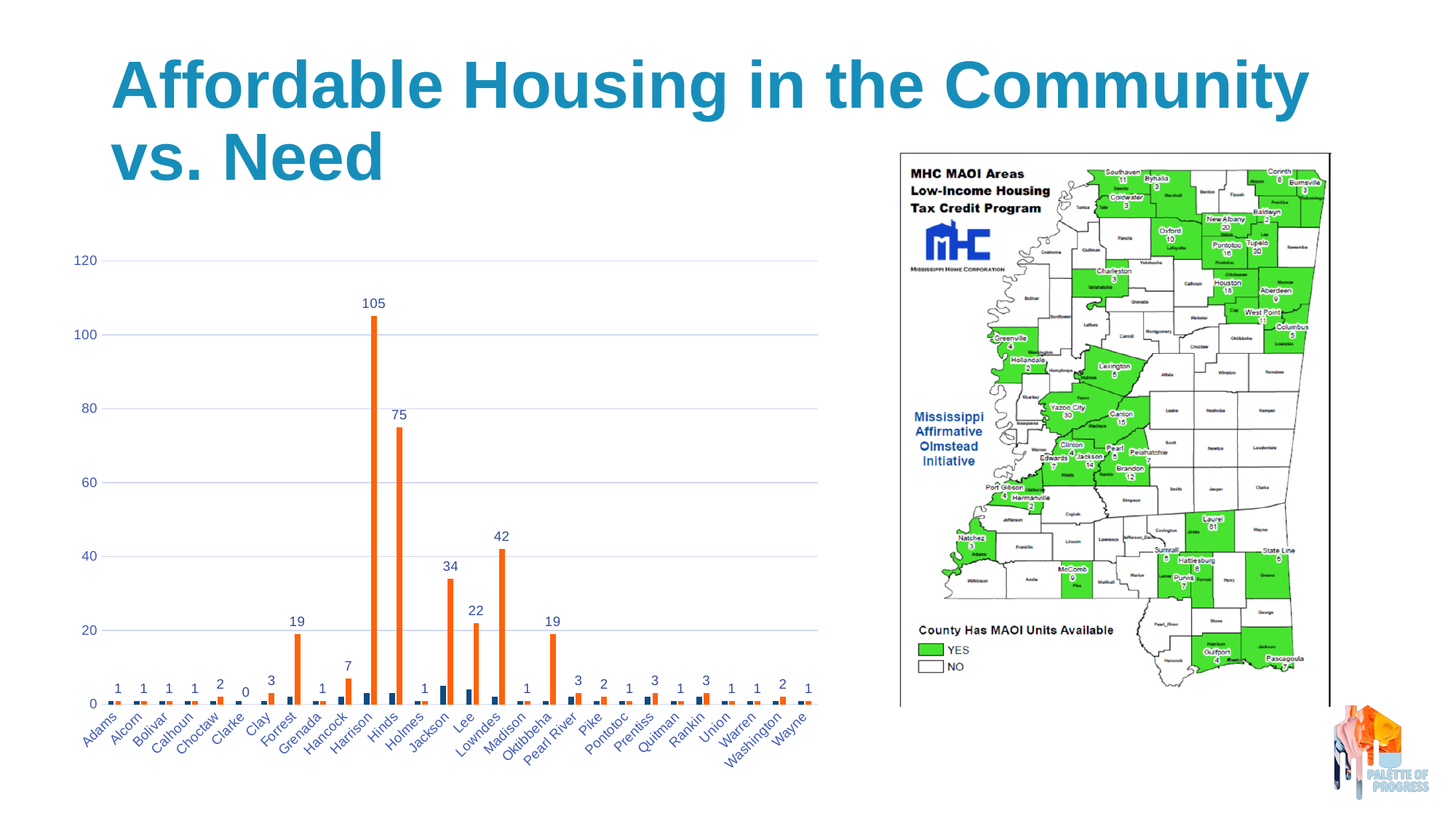
Which has a larger orange bar value, Jackson or Lee? Jackson What is the value of the orange bar for Hinds? 75 Which county has the highest orange bar? Harrison How many counties are shown on the x axis of the bar chart? 28 What is the difference between the orange bar values for Harrison and Hinds? 30 What is the value of the orange bar for Lowndes? 42 Is the orange bar value for Hinds greater or less than 60? greater What is the value of the orange bar for Clarke? 0 What is the value of the orange bar for Harrison? 105 What kind of chart is shown on the slide? bar chart What is the title of the slide? Affordable Housing in the Community vs. Need What is the value of the orange bar for Forrest? 19